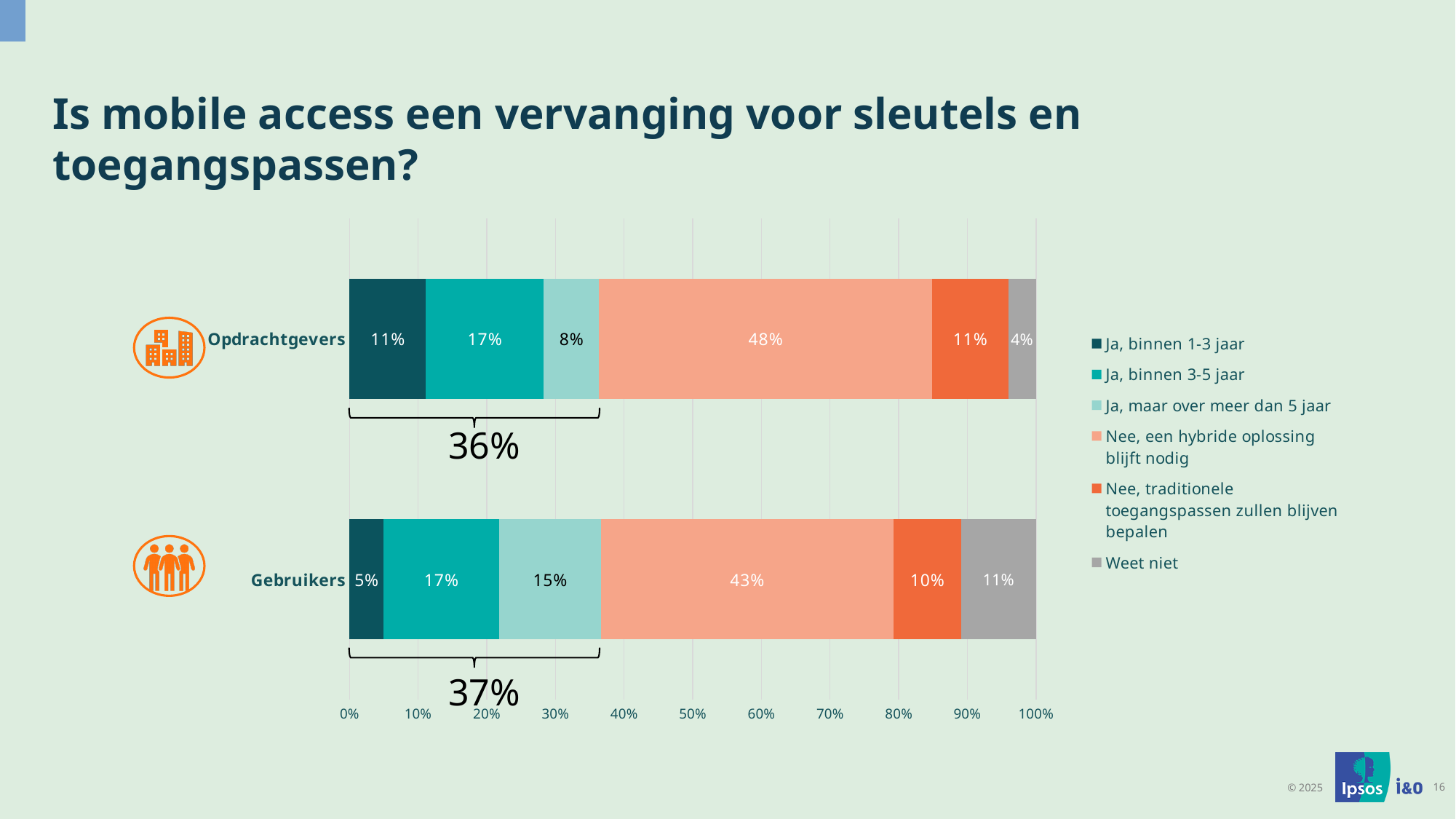
What is the difference between the "Ja, maar over meer dan 5 jaar" share for Gebruikers and for Opdrachtgevers? 7 percentage points How many series does the legend list? 6 What kind of chart is shown on the slide? Stacked bar chart What percentage of Gebruikers answered "Ja, binnen 1-3 jaar"? 5% What percentage of Opdrachtgevers answered "Nee, een hybride oplossing blijft nodig"? 48% How many groups (bars) are shown in the chart? 2 What percentage of Opdrachtgevers answered "Ja, maar over meer dan 5 jaar"? 8% Which group has a larger share for "Ja, binnen 1-3 jaar", Opdrachtgevers or Gebruikers? Opdrachtgevers What is the combined share of all "Ja" answers for Gebruikers, as shown by the bracket under the bar? 37% Which answer category has the largest share among Gebruikers? Nee, een hybride oplossing blijft nodig Which answer category has the smallest share among Opdrachtgevers? Weet niet What percentage of Gebruikers answered "Weet niet"? 11%